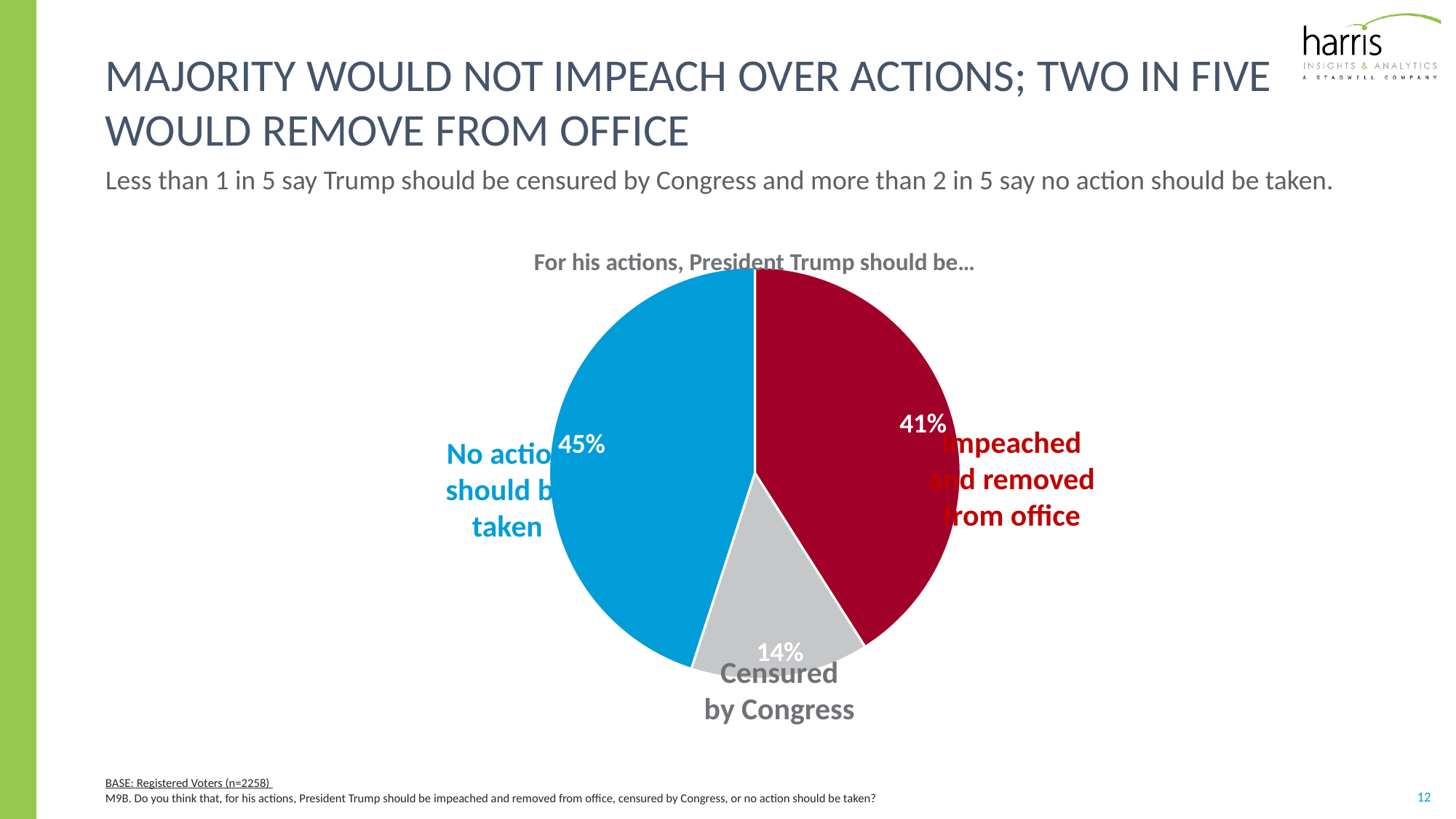
What is the chart's title? For his actions, President Trump should be… Which response has the largest share of the pie? No action should be taken What kind of chart is shown on the slide? pie chart Which response has the smallest share of the pie? Censured by Congress What is the difference in percentage points between 'Impeached and removed from office' and 'Censured by Congress'? 27 What colour is the slice for 'No action should be taken'? blue What is the difference in percentage points between 'No action should be taken' and 'Impeached and removed from office'? 4 What percentage say President Trump should be censured by Congress? 14% What percentage say no action should be taken? 45% Which is larger: the share for 'Censured by Congress' or the share for 'Impeached and removed from office'? Impeached and removed from office How many slices does the pie chart have? 3 What percentage say President Trump should be impeached and removed from office? 41%